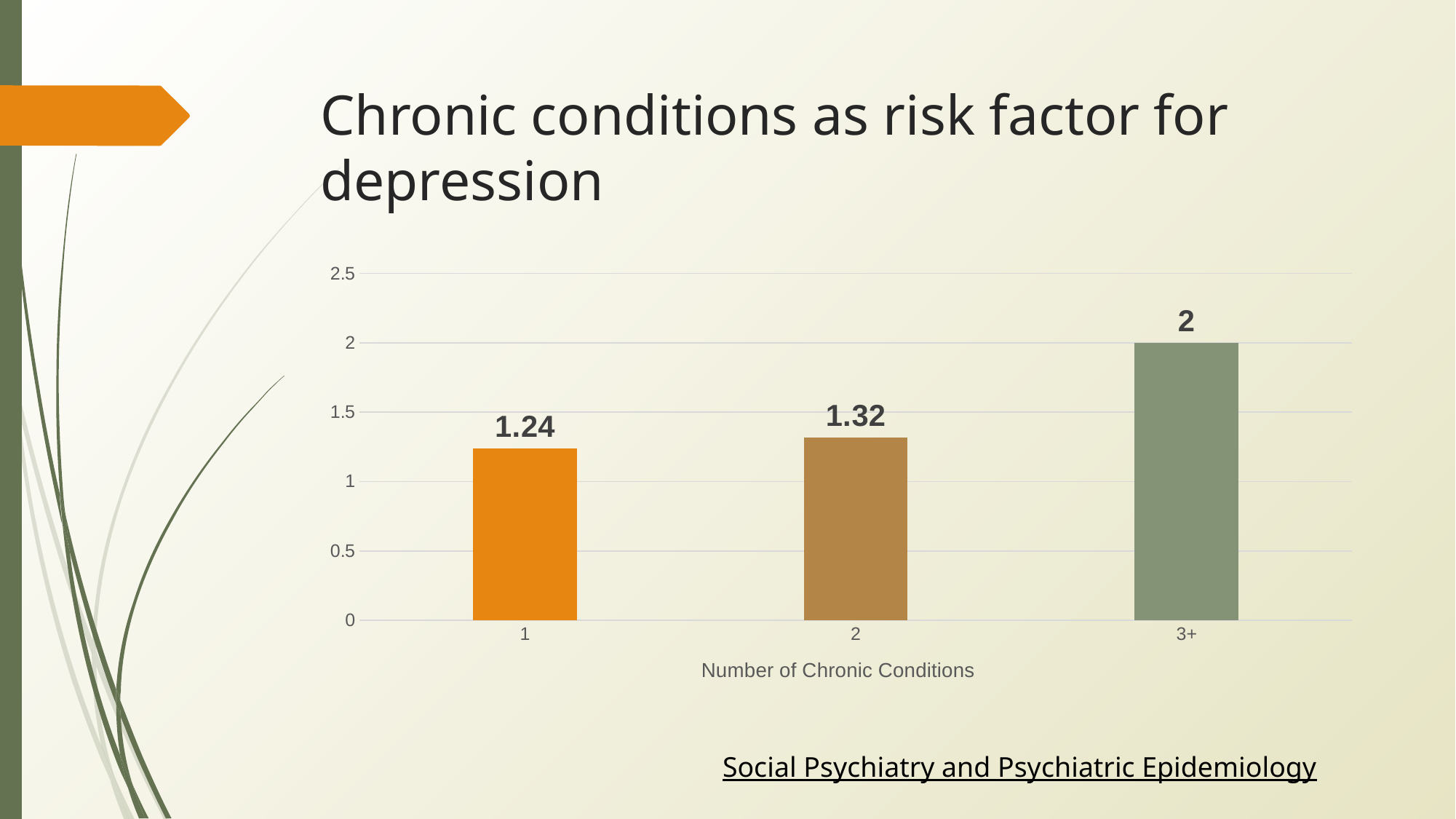
Which number of chronic conditions has the lowest value? 1 Is the value for 1 chronic condition greater or less than 1.5? less What is the value for 2 chronic conditions? 1.32 What is the difference between the values for 3+ and 1 chronic conditions? 0.76 How many categories are shown on the x axis? 3 Which number of chronic conditions has the highest value? 3+ What is the value for 3+ chronic conditions? 2 Which is larger, the value for 2 chronic conditions or for 3+ chronic conditions? 3+ What is the value for 1 chronic condition? 1.24 What is the difference between the values for 2 and 1 chronic conditions? 0.08 Do the values rise or fall as the number of chronic conditions increases? rise What kind of chart is shown on the slide? bar chart